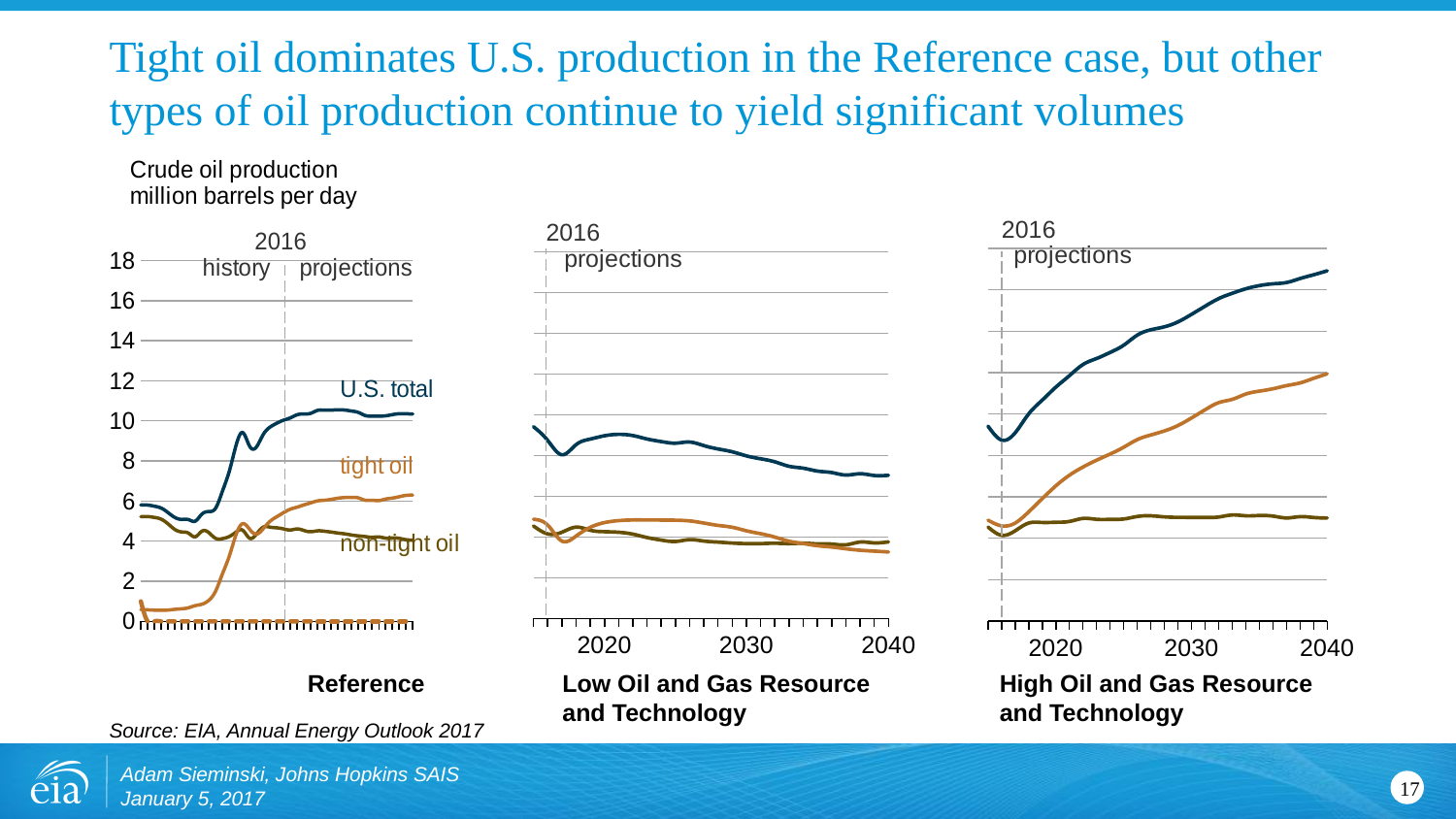
Which of the three charts shows the highest U.S. total in 2040? High Oil and Gas Resource and Technology In the Low Oil and Gas Resource and Technology chart, does the U.S. total rise or fall from 2020 to 2040? fall In the Reference chart, is non-tight oil production in 2040 greater or less than 6? less In the Low Oil and Gas Resource and Technology chart, is the U.S. total in 2040 greater or less than 8? less In the High Oil and Gas Resource and Technology chart, is the U.S. total in 2040 greater or less than 16? greater In the Reference chart, how many series are labelled? 3 How many charts are shown on the slide? 3 In the High Oil and Gas Resource and Technology chart, does the U.S. total rise or fall over the projection period? rise What kind of chart is used on this slide? line chart What unit is crude oil production measured in on these charts? million barrels per day In the Reference chart, which is larger in 2040: tight oil or non-tight oil? tight oil